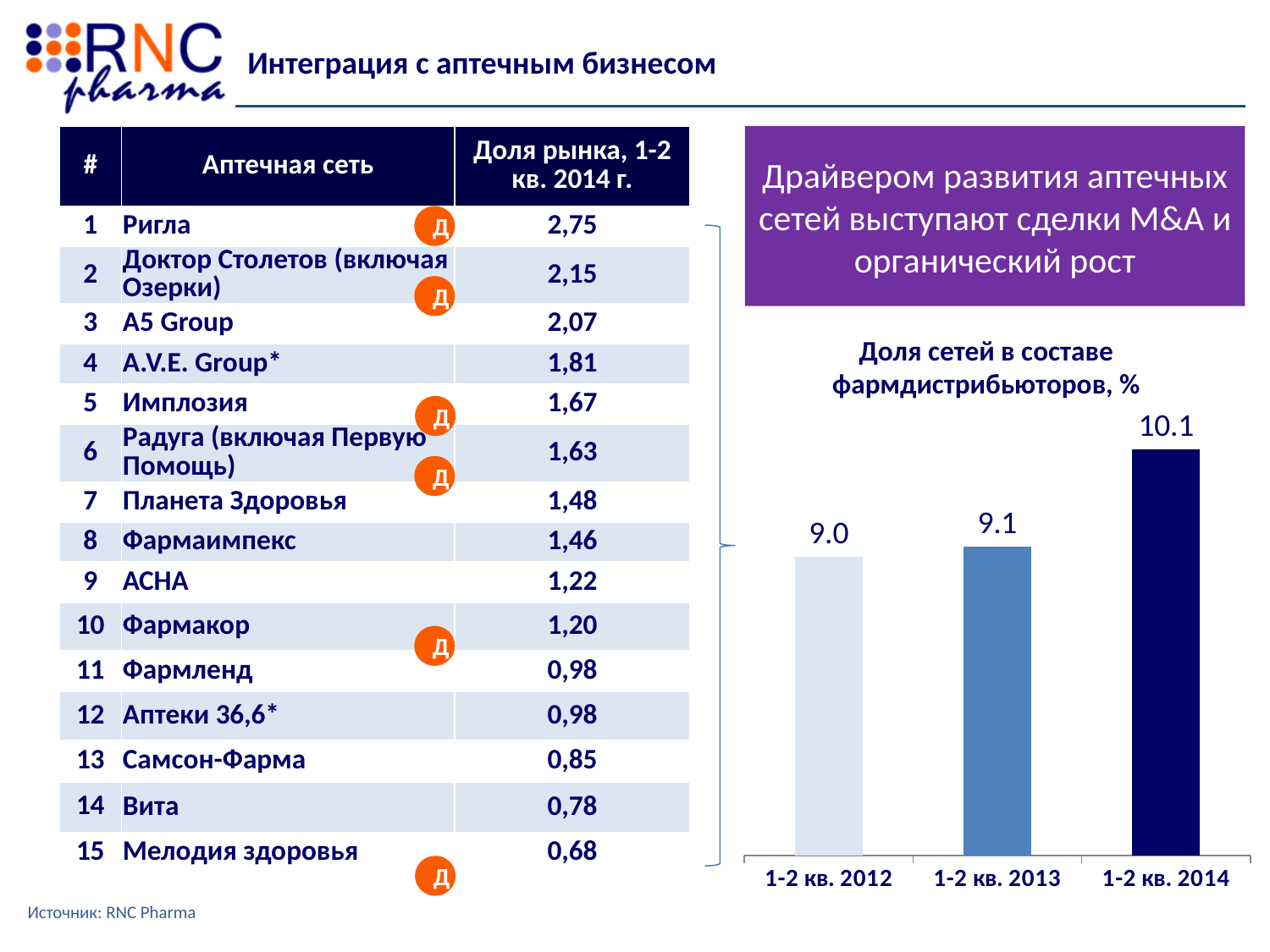
Which period has the lowest value in the chart 'Доля сетей в составе фармдистрибьюторов, %'? 1-2 кв. 2012 What is the title of the bar chart on the slide? Доля сетей в составе фармдистрибьюторов, % What is the value for 1-2 кв. 2012 in the chart 'Доля сетей в составе фармдистрибьюторов, %'? 9.0 Which period has the highest value in the chart 'Доля сетей в составе фармдистрибьюторов, %'? 1-2 кв. 2014 How many bars are plotted in the chart 'Доля сетей в составе фармдистрибьюторов, %'? 3 Do the values in the chart 'Доля сетей в составе фармдистрибьюторов, %' rise or fall from 1-2 кв. 2012 to 1-2 кв. 2014? rise What is the difference between the values for 1-2 кв. 2014 and 1-2 кв. 2012 in the chart 'Доля сетей в составе фармдистрибьюторов, %'? 1.1 What kind of chart is 'Доля сетей в составе фармдистрибьюторов, %'? bar chart What is the difference between the values for 1-2 кв. 2014 and 1-2 кв. 2013 in the chart 'Доля сетей в составе фармдистрибьюторов, %'? 1.0 What is the value for 1-2 кв. 2013 in the chart 'Доля сетей в составе фармдистрибьюторов, %'? 9.1 In the chart 'Доля сетей в составе фармдистрибьюторов, %', which is larger: the value for 1-2 кв. 2014 or 1-2 кв. 2012? 1-2 кв. 2014 What is the value for 1-2 кв. 2014 in the chart 'Доля сетей в составе фармдистрибьюторов, %'? 10.1